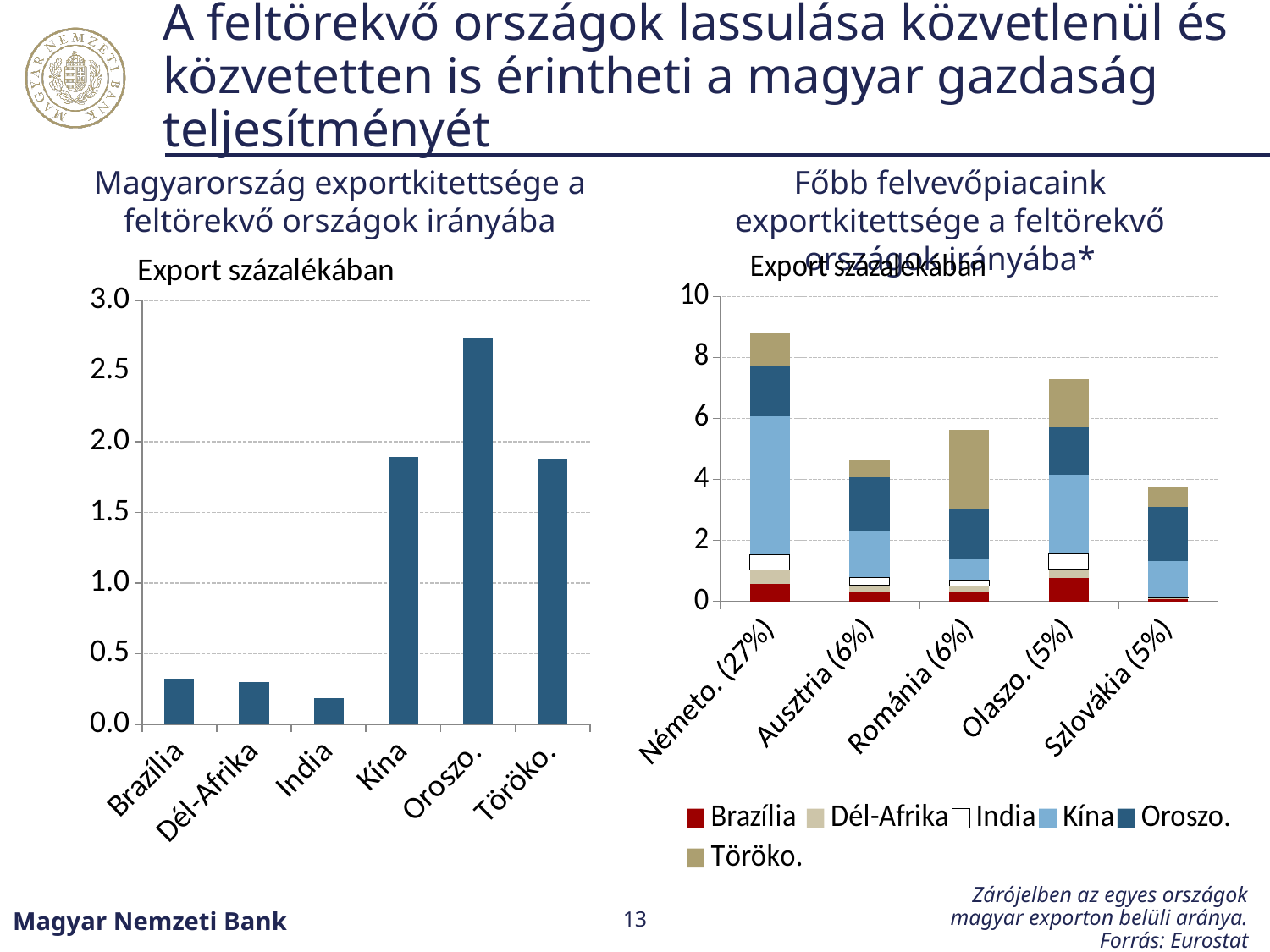
In the left chart (Magyarország exportkitettsége a feltörekvő országok irányába), which country has the highest value? Oroszo. In the right chart (Főbb felvevőpiacaink exportkitettsége a feltörekvő országok irányába), which country has the tallest stacked bar? Németo. (27%) In the left chart, which is larger, the value for Kína or the value for Brazília? Kína In the left chart, is the value for Kína greater or less than 1.5? greater In the left chart, is the value for India greater or less than 0.5? less How many countries are shown on the x axis of the left chart? 6 What kind of chart is the left chart? bar chart How many series does the legend of the right chart list? 6 In the right chart (Főbb felvevőpiacaink exportkitettsége a feltörekvő országok irányába), which country has the shortest stacked bar? Szlovákia (5%) In the left chart, is the value for Oroszo. greater or less than 2.5? greater In the left chart (Magyarország exportkitettsége a feltörekvő országok irányába), which country has the lowest value? India